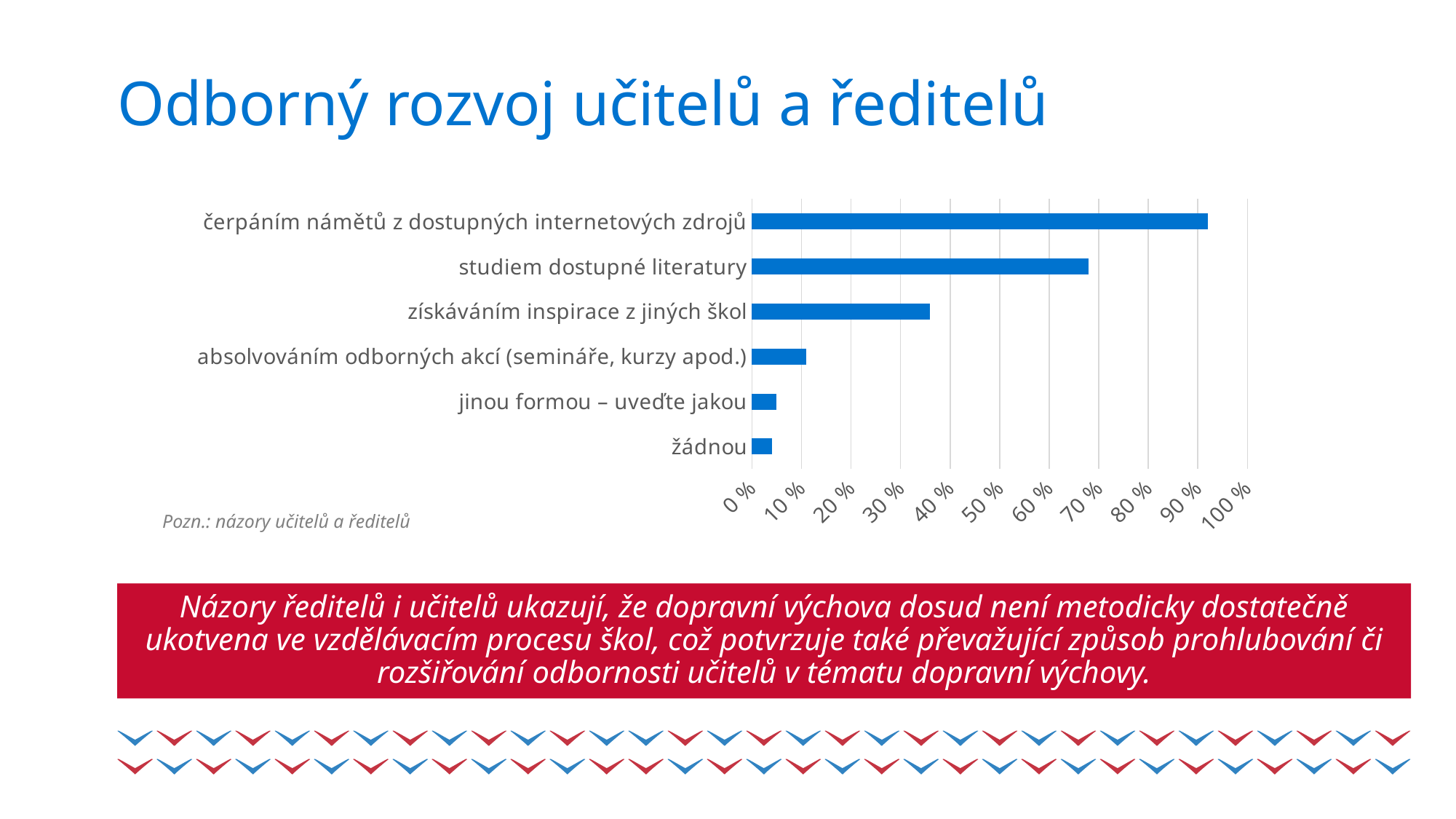
Which category has the highest value? čerpáním námětů z dostupných internetových zdrojů Is the value for 'získáváním inspirace z jiných škol' greater or less than 40 %? less Is the value for 'žádnou' greater or less than 10 %? less Is the value for 'čerpáním námětů z dostupných internetových zdrojů' greater or less than 80 %? greater What is the title of the slide containing the chart? Odborný rozvoj učitelů a ředitelů What kind of chart is shown on the slide? bar chart Which is larger: the value for 'studiem dostupné literatury' or for 'získáváním inspirace z jiných škol'? studiem dostupné literatury How many categories does the chart show? 6 Which is larger: the value for 'absolvováním odborných akcí (semináře, kurzy apod.)' or for 'jinou formou – uveďte jakou'? absolvováním odborných akcí (semináře, kurzy apod.)